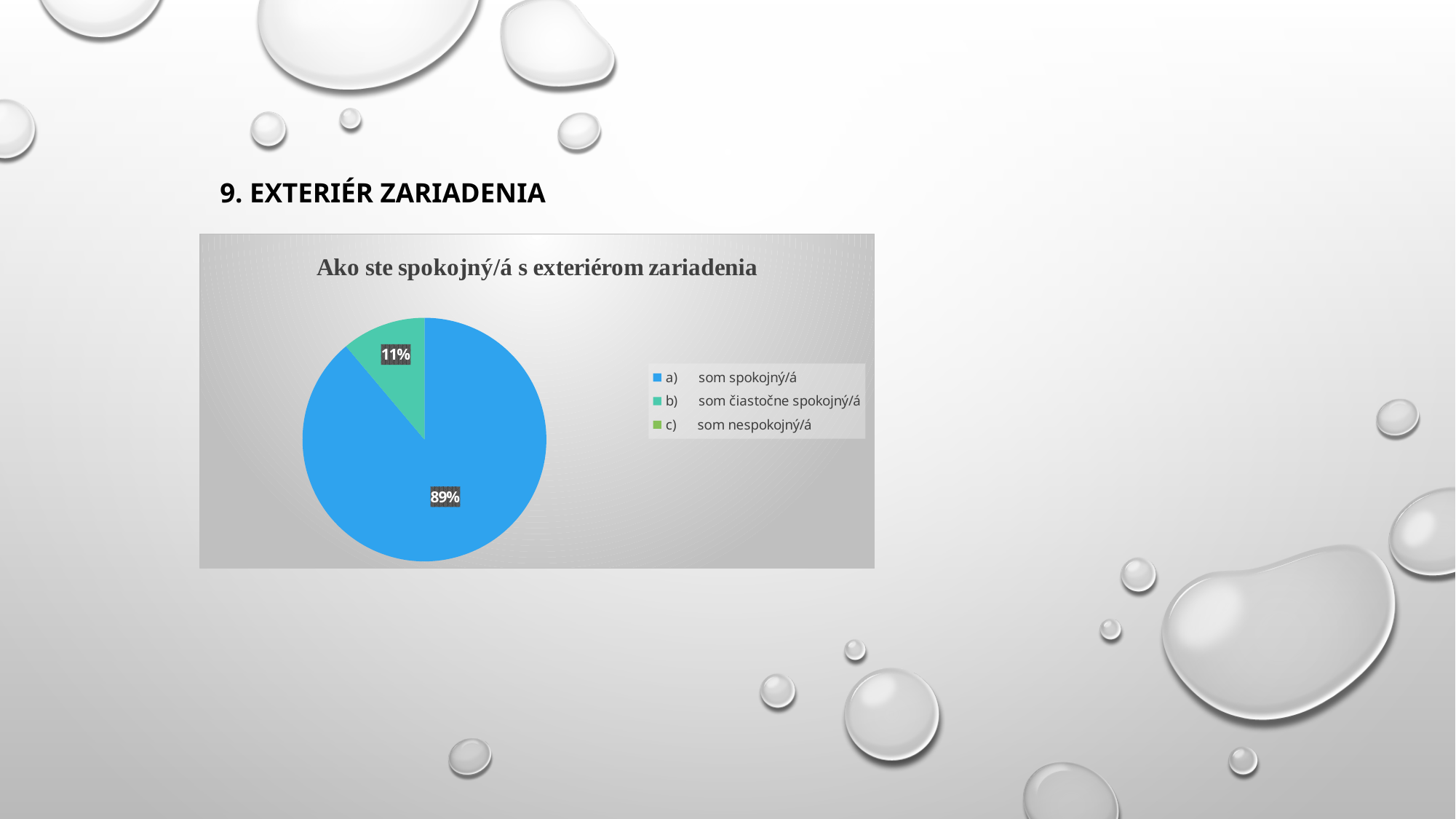
How many entries does the legend list? 3 What share of the pie does "a) som spokojný/á" take? 89% What is the title of the chart? Ako ste spokojný/á s exteriérom zariadenia What share of the pie does "b) som čiastočne spokojný/á" take? 11% What kind of chart is shown on the slide? pie chart Which of the two labelled slices is smaller, "a) som spokojný/á" or "b) som čiastočne spokojný/á"? b) som čiastočne spokojný/á What colour is the slice for "a) som spokojný/á"? blue How many slices are visibly labelled with a percentage on the pie? 2 Which category has the largest slice of the pie? a) som spokojný/á What is the difference in percentage points between the "a) som spokojný/á" slice and the "b) som čiastočne spokojný/á" slice? 78 percentage points Is the share for "a) som spokojný/á" greater or less than 50%? greater